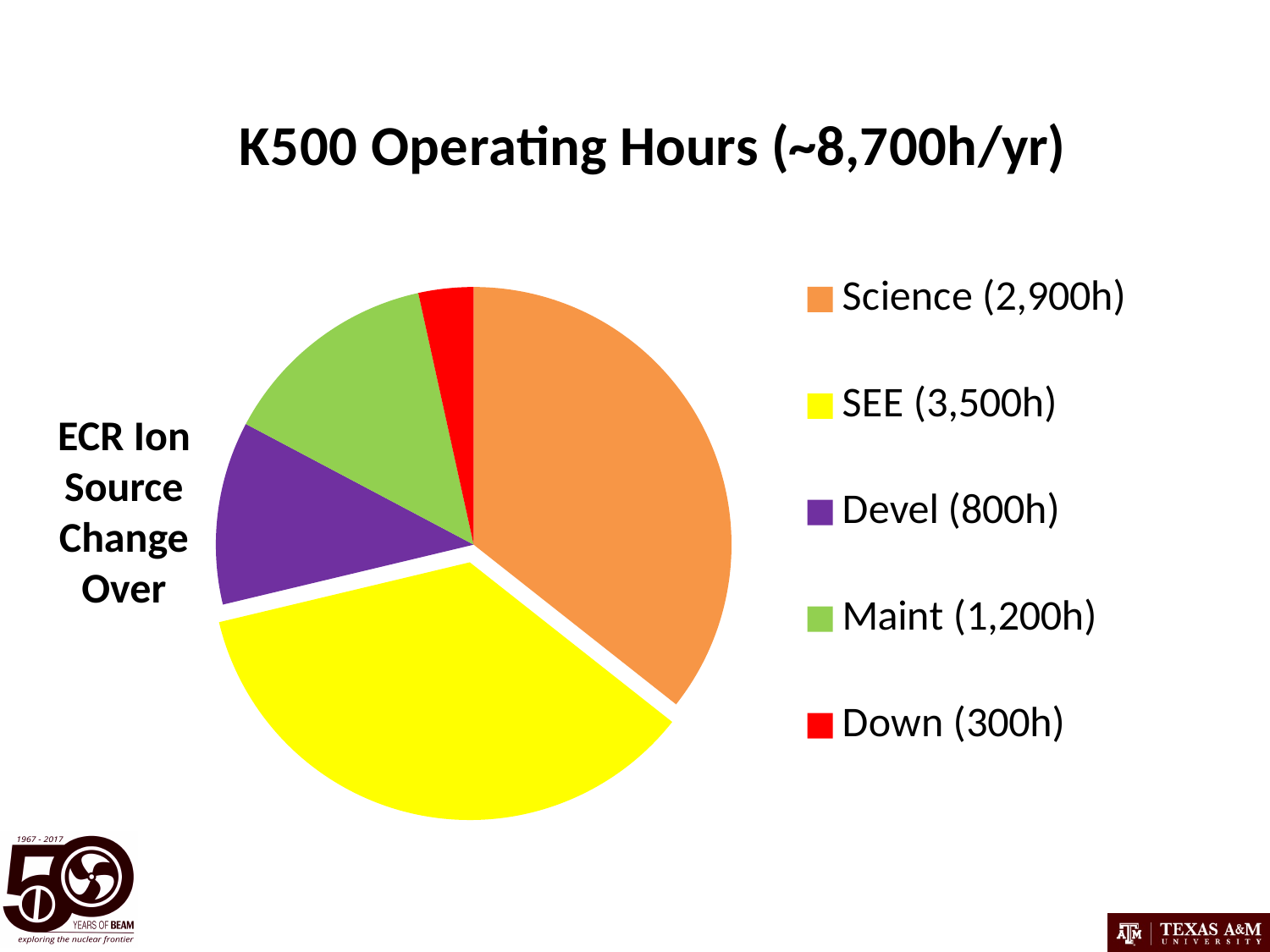
What is the difference in hours between Maint and Devel? 400h Which category has the smallest share of operating hours? Down How many hours are shown for Down? 300h How many hours are shown for Science? 2,900h What colour is the SEE slice of the pie chart? yellow What type of chart is shown on the slide? pie chart How many more hours does SEE have than Science? 600h Which category has the largest share of operating hours? SEE How many categories does the pie chart have? 5 How many hours are shown for Maint? 1,200h Which has more hours, Devel or Maint? Maint What is the total number of operating hours across all categories? 8,700h